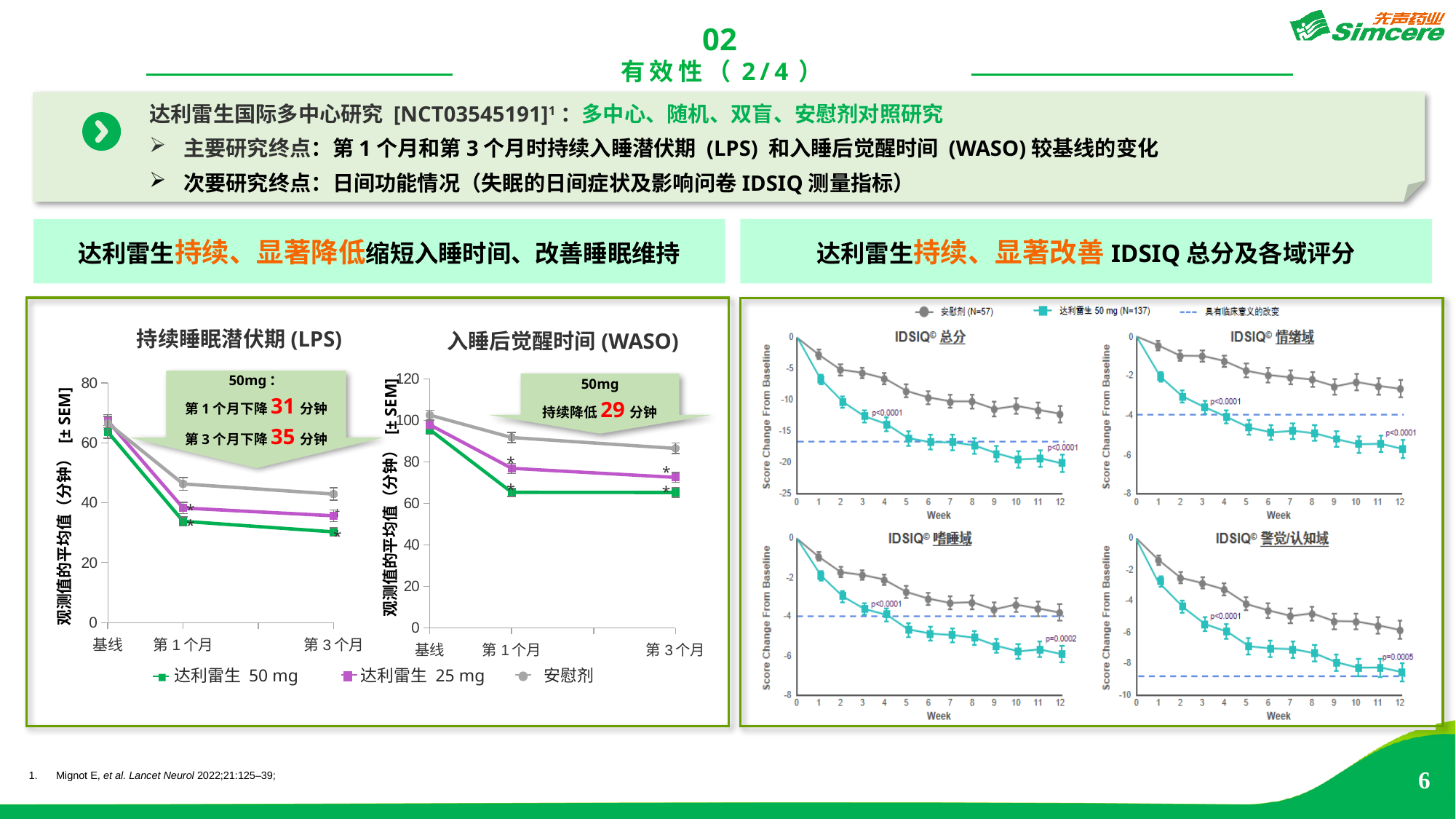
In the IDSIQ 总分 chart on the right, is the value for 达利雷生 50 mg at Week 12 greater or less than -15? less In the 持续睡眠潜伏期 (LPS) chart, does the 达利雷生 50 mg line rise or fall from 基线 to 第3个月? fall In the 持续睡眠潜伏期 (LPS) chart, is the value for 安慰剂 at 第1个月 greater or less than 40? greater How many series does the legend of the LPS and WASO charts list? 3 In the 入睡后觉醒时间 (WASO) chart, is the value for 安慰剂 at 第3个月 greater or less than 80? greater In the 持续睡眠潜伏期 (LPS) chart, which is larger at 第3个月: 安慰剂 or 达利雷生 50 mg? 安慰剂 According to the callout on the LPS chart, by how many minutes did 达利雷生 50mg reduce LPS at 第1个月? 31 分钟 What kind of chart is the 持续睡眠潜伏期 (LPS) chart? line chart In the IDSIQ charts on the right, what sample size does the legend give for 安慰剂? N=57 How many time points are shown on the x axis of the 持续睡眠潜伏期 (LPS) chart? 3